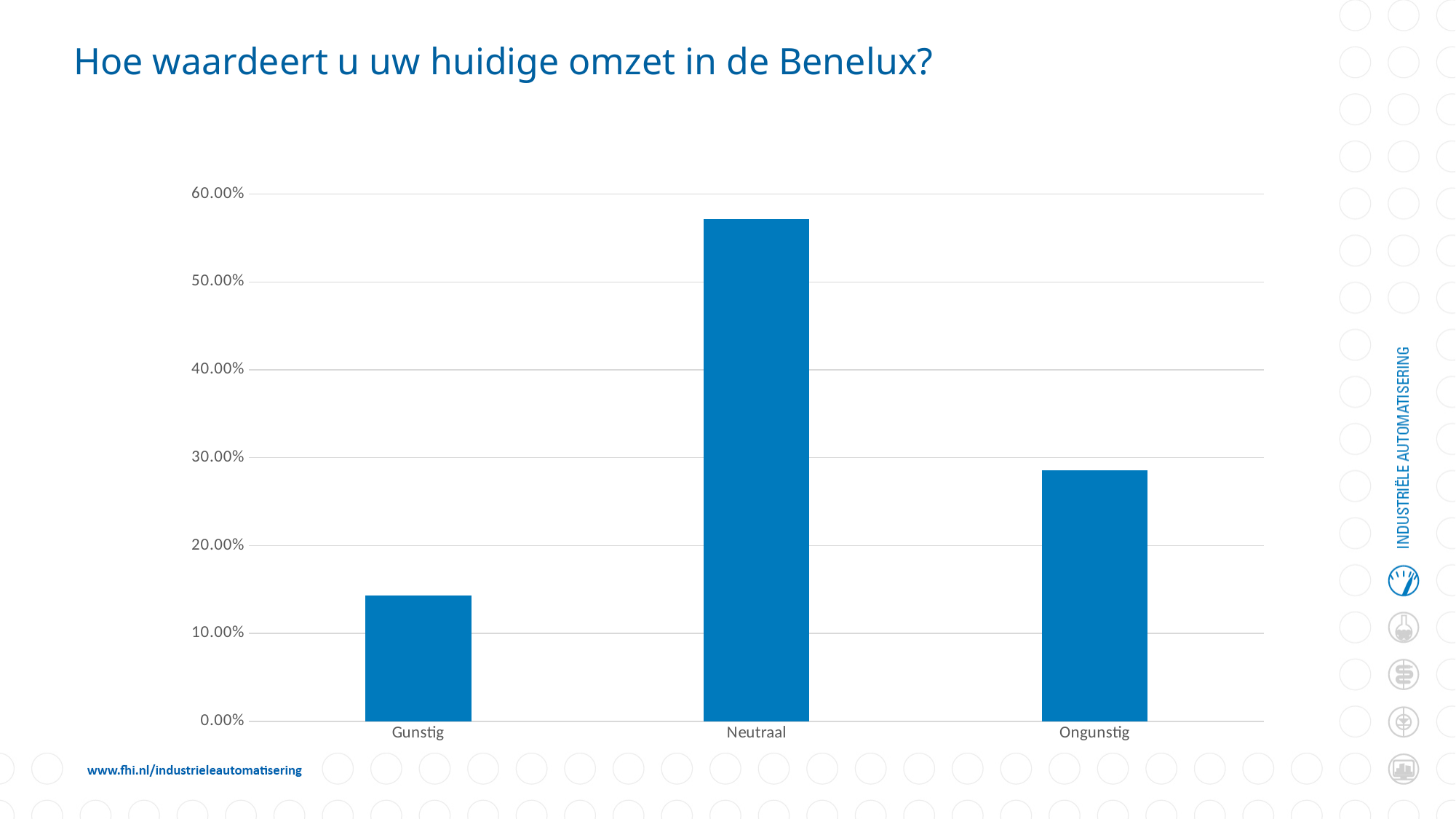
Which is larger, the value for Neutraal or the value for Ongunstig? Neutraal Which category has the highest value in the chart? Neutraal Is the value for Gunstig greater or less than 20.00%? less Is the value for Ongunstig greater or less than 20.00%? greater Which category has the lowest value in the chart? Gunstig What is the title of the slide containing the chart? Hoe waardeert u uw huidige omzet in de Benelux? Which is larger, the value for Ongunstig or the value for Gunstig? Ongunstig How many categories are shown on the x axis of the chart? 3 What kind of chart is shown on the slide? bar chart Is the value for Ongunstig greater or less than 30.00%? less What is the highest value shown on the y axis of the chart? 60.00%